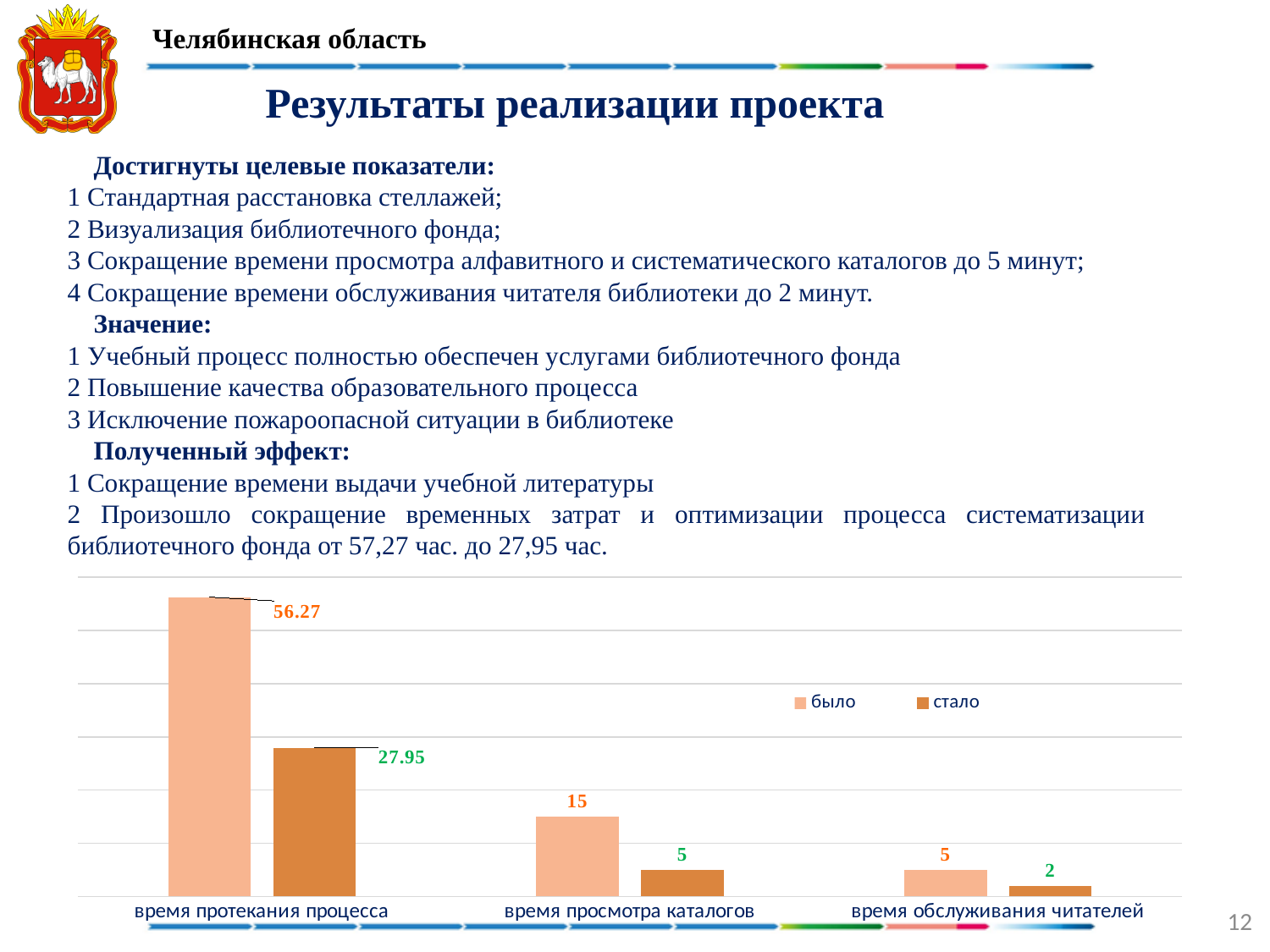
What is the difference between the "было" and "стало" values for "время протекания процесса"? 28.32 Which is larger: the "стало" value for "время просмотра каталогов" or the "было" value for "время обслуживания читателей"? They are equal (5) How many series does the chart legend list? 2 What is the value of the "было" series for "время просмотра каталогов"? 15 What is the value of the "стало" series for "время обслуживания читателей"? 2 Which category has the lowest "стало" value? время обслуживания читателей How many categories are shown on the x axis of the chart? 3 What is the value of the "стало" series for "время протекания процесса"? 27.95 What is the value of the "было" series for "время протекания процесса"? 56.27 What is the difference between the "было" and "стало" values for "время просмотра каталогов"? 10 Which category has the highest "было" value? время протекания процесса What type of chart is shown on the slide? Bar chart